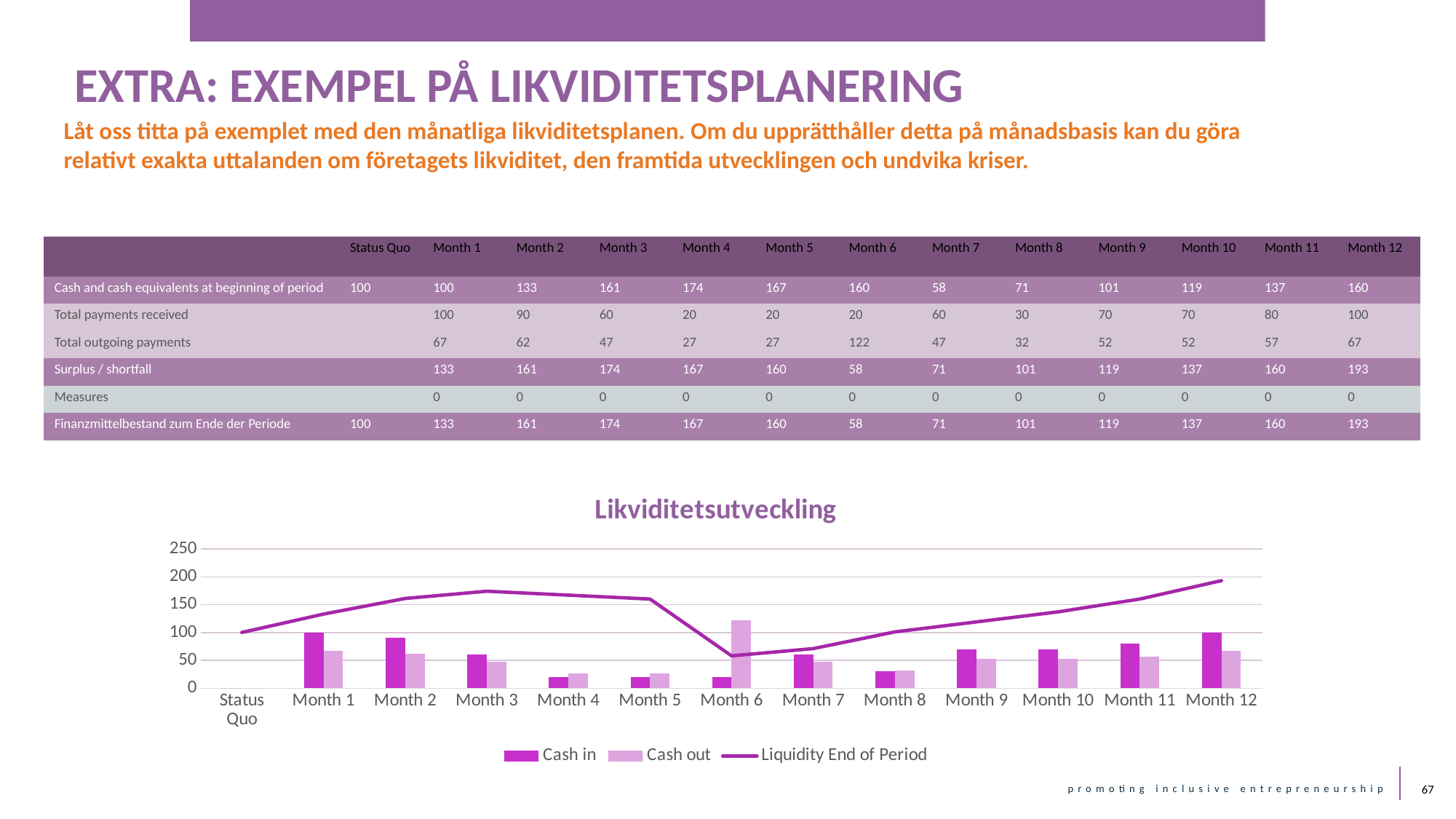
What is the title of the chart on the slide? Likviditetsutveckling In the 'Likviditetsutveckling' chart, what is the Cash in value for Month 1? 100 In the 'Likviditetsutveckling' chart, does Liquidity End of Period rise or fall from Month 6 to Month 12? rise In the 'Likviditetsutveckling' chart, is the Liquidity End of Period value for Month 12 greater or less than 150? greater In the 'Likviditetsutveckling' chart, which is larger for Month 6: Cash in or Cash out? Cash out What kind of chart is 'Likviditetsutveckling'? combined bar and line chart How many categories are shown on the x axis of the 'Likviditetsutveckling' chart? 13 In the 'Likviditetsutveckling' chart, in which month is Liquidity End of Period lowest? Month 6 In the 'Likviditetsutveckling' chart, in which month is Cash out highest? Month 6 In the 'Likviditetsutveckling' chart, is the Cash out value for Month 6 greater or less than 100? greater How many series does the legend of the 'Likviditetsutveckling' chart list? 3 In the 'Likviditetsutveckling' chart, which is larger for Month 1: Cash in or Cash out? Cash in